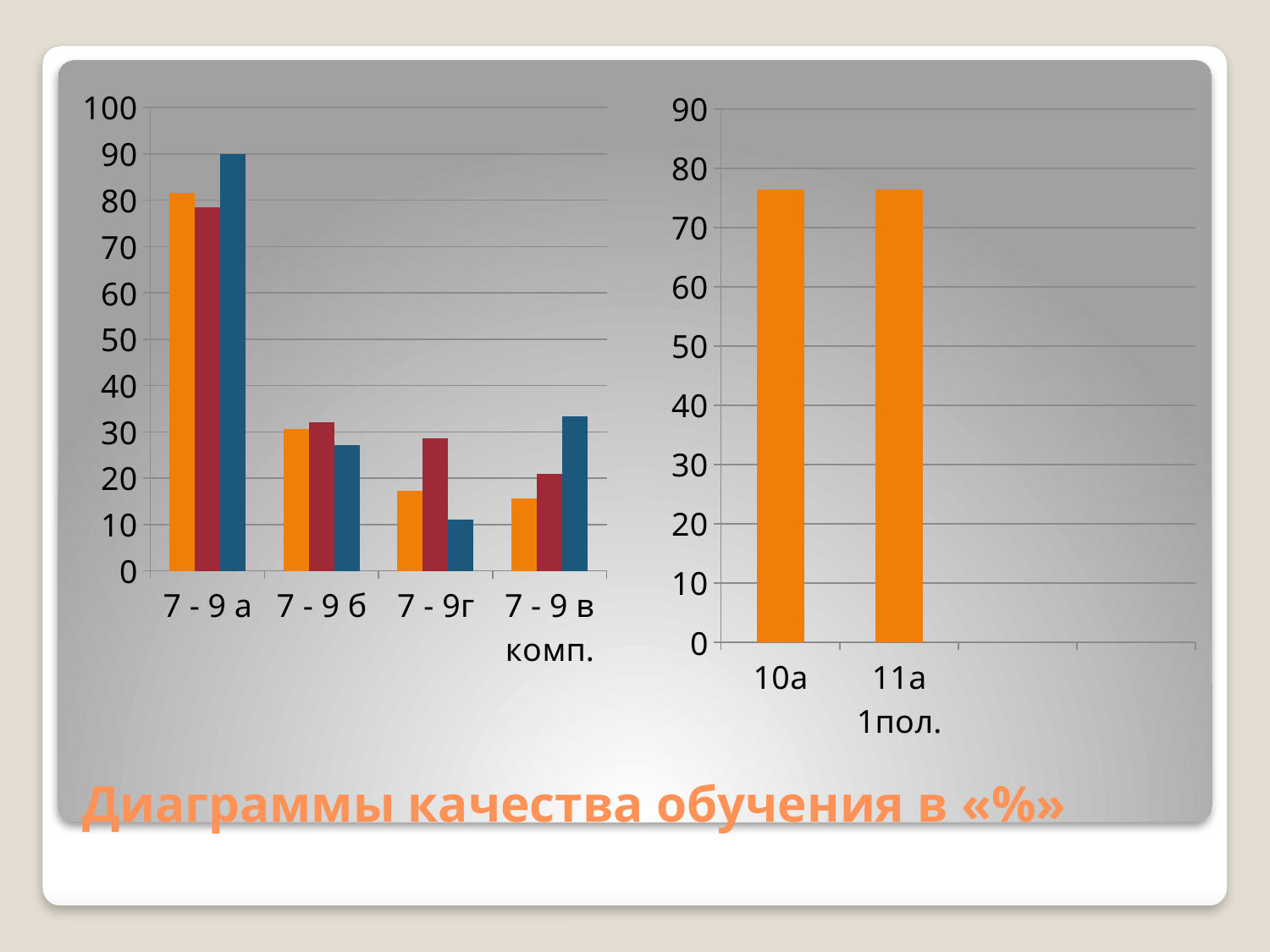
What kind of chart is the left chart? bar chart In the left chart, which category contains the tallest bar? 7 - 9 а In the left chart, is the blue bar for 7 - 9 а greater or less than 80? greater In the left chart, which category contains the shortest bar? 7 - 9г In the left chart, how many bars (series) are plotted for each category? 3 How many categories are shown on the x axis of the right chart? 2 In the right chart, is the value for 10а greater or less than 70? greater In the left chart, which is larger: the blue bar for 7 - 9 а or the blue bar for 7 - 9 б? 7 - 9 а What kind of chart is the right chart? bar chart In the right chart, is the value for 11а greater or less than 80? less How many categories are shown on the x axis of the left chart? 4